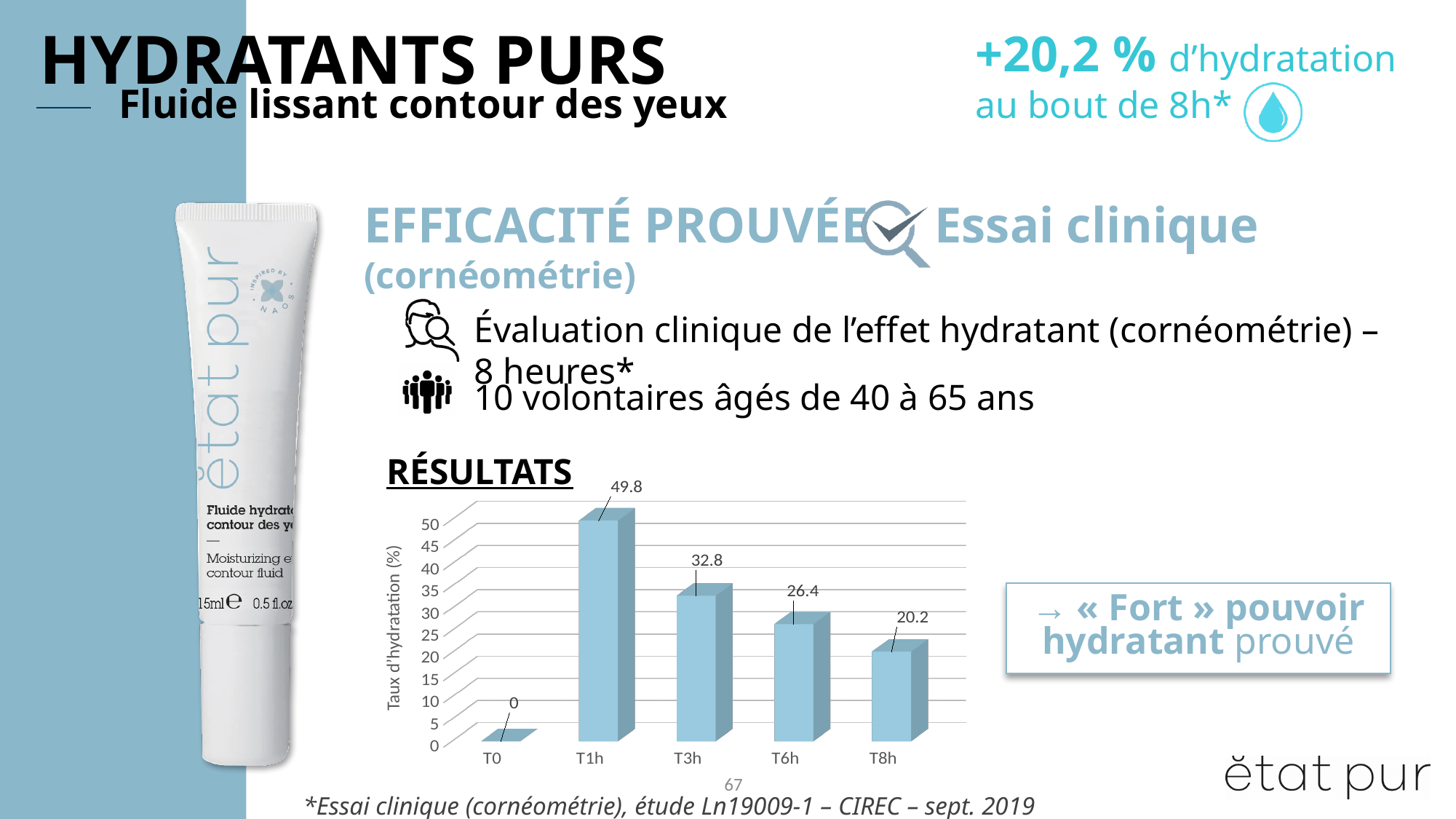
Which category has the lowest value? T0 What is the label of the y axis? Taux d'hydratation (%) What is the value for T6h? 26.4 Which is larger, the value for T3h or the value for T6h? T3h Which category has the highest value? T1h What is the value for T8h? 20.2 What is the value for T1h? 49.8 What kind of chart is shown? bar chart What is the value for T0? 0 How many categories are shown on the x axis? 5 What is the value for T3h? 32.8 What is the difference between the values for T1h and T8h? 29.6